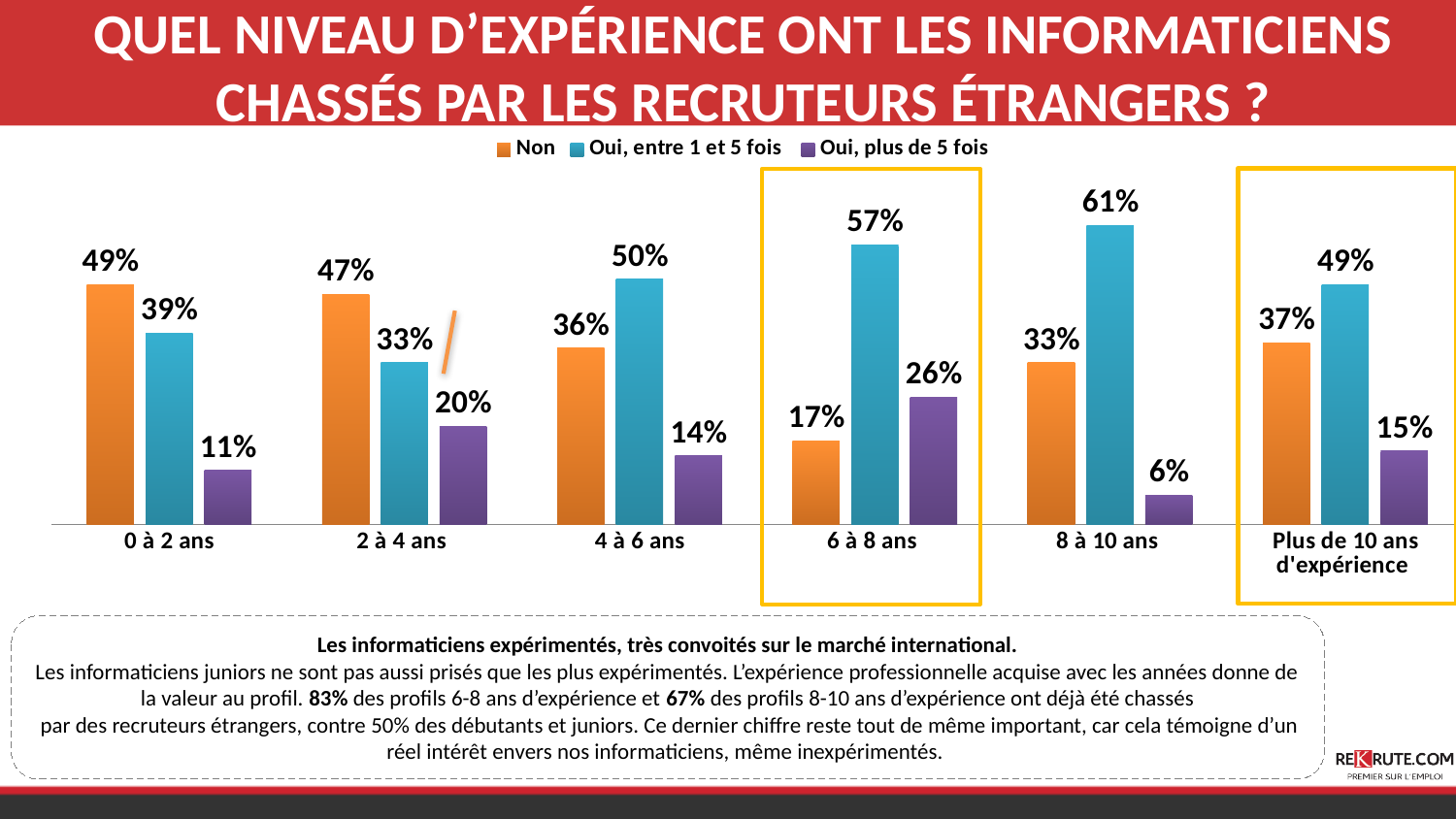
What is the value of "Non" for the "0 à 2 ans" category? 49% Which series is shown in orange in the legend? Non How many experience categories are shown on the x axis? 6 What is the difference between "Oui, entre 1 et 5 fois" and "Non" for the "6 à 8 ans" category? 40% Which category has the highest value for "Oui, entre 1 et 5 fois"? 8 à 10 ans How many series does the legend list? 3 Which category has the lowest value for "Non"? 6 à 8 ans What type of chart is shown on the slide? bar chart What is the value of "Oui, plus de 5 fois" for the "6 à 8 ans" category? 26% For the "2 à 4 ans" category, which is larger: "Non" or "Oui, entre 1 et 5 fois"? Non Which category has the lowest value for "Oui, plus de 5 fois"? 8 à 10 ans What is the value of "Oui, entre 1 et 5 fois" for the "8 à 10 ans" category? 61%